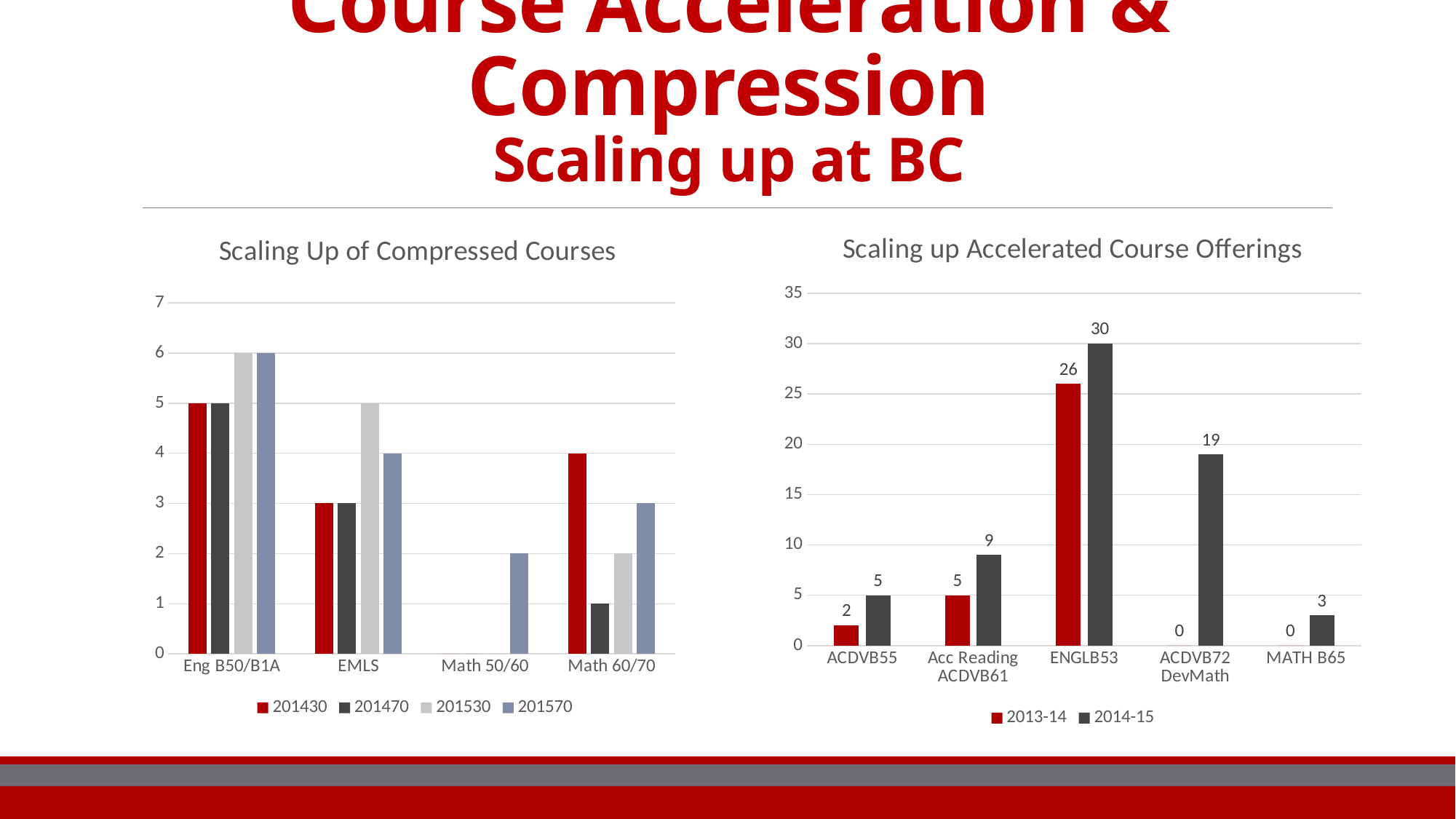
In the 'Scaling Up of Compressed Courses' chart, which category has the highest 201530 value? Eng B50/B1A In the 'Scaling up Accelerated Course Offerings' chart, what is the 2013-14 value for ACDVB55? 2 What kind of chart is 'Scaling Up of Compressed Courses'? Bar chart In the 'Scaling Up of Compressed Courses' chart, what is the 201430 value for Math 60/70? 4 In the 'Scaling up Accelerated Course Offerings' chart, which category has the highest 2014-15 value? ENGLB53 In the 'Scaling up Accelerated Course Offerings' chart, what are the two legend entries? 2013-14 and 2014-15 In the 'Scaling up Accelerated Course Offerings' chart, how many categories are shown on the x axis? 5 In the 'Scaling Up of Compressed Courses' chart, how many series does the legend list? 4 In the 'Scaling up Accelerated Course Offerings' chart, what is the difference between the 2014-15 and 2013-14 values for ACDVB72 DevMath? 19 In the 'Scaling Up of Compressed Courses' chart, what is the 201570 value for Math 50/60? 2 In the 'Scaling up Accelerated Course Offerings' chart, what is the 2014-15 value for ENGLB53? 30 In the 'Scaling up Accelerated Course Offerings' chart, which is larger for Acc Reading ACDVB61: the 2013-14 value or the 2014-15 value? 2014-15